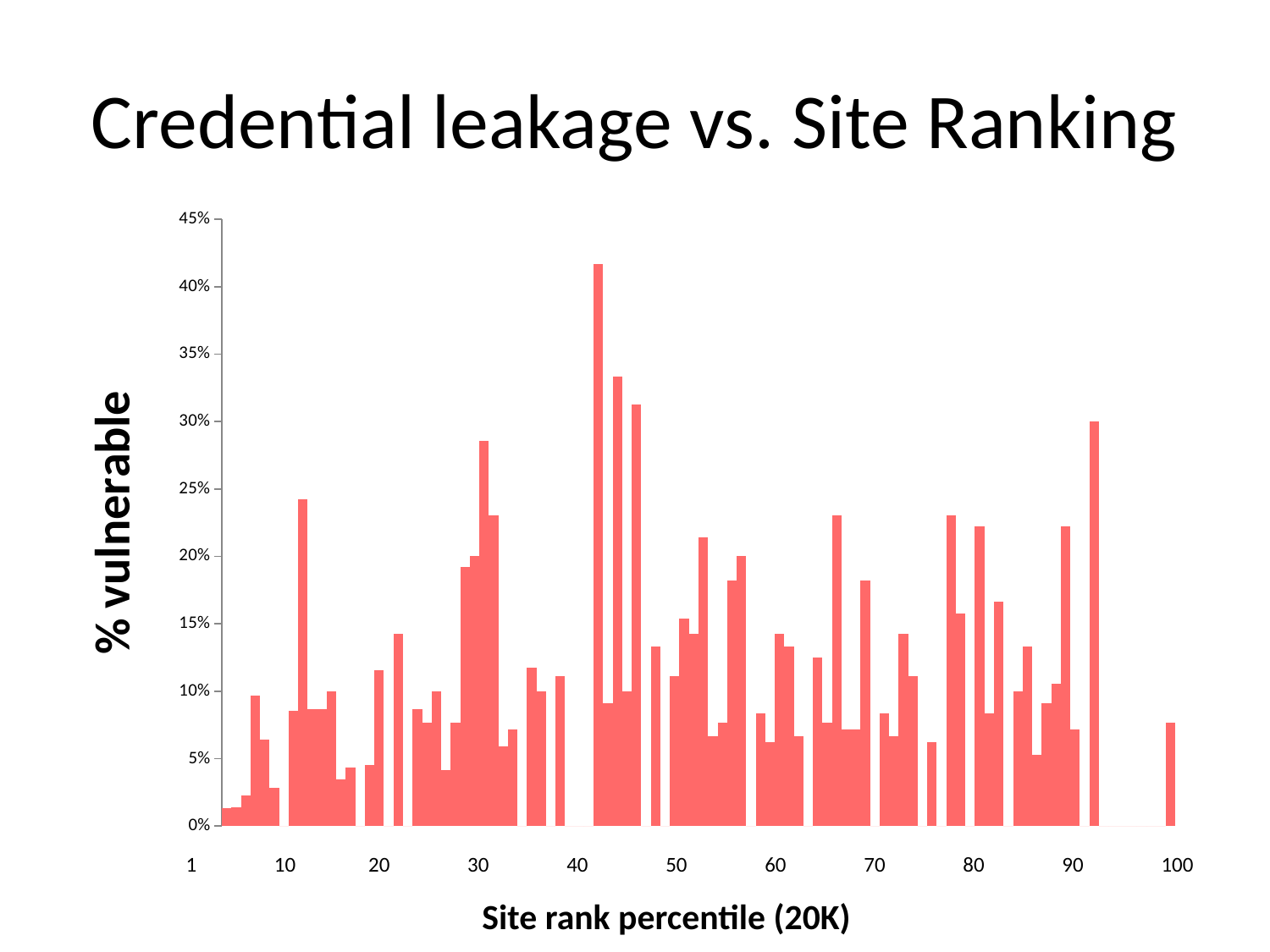
Is the value of the bar at site rank percentile 100 greater or less than 10%? less Is the value of the tallest bar in the chart greater or less than 35%? greater What is the title of the chart on the slide? Credential leakage vs. Site Ranking Between which two labelled x-axis ticks does the tallest bar of the chart fall? between 40 and 50 Is the value of the tallest bar between x-axis ticks 30 and 40 greater or less than 25%? greater What is the highest value labelled on the y axis of the chart? 45% Which is larger: the tallest bar between x-axis ticks 40 and 50, or the tallest bar between x-axis ticks 90 and 100? the tallest bar between 40 and 50 Which is larger: the tallest bar between x-axis ticks 20 and 30, or the tallest bar between x-axis ticks 30 and 40? the tallest bar between 30 and 40 What kind of chart is shown on the slide? bar chart What is the label of the x axis of the chart? Site rank percentile (20K)